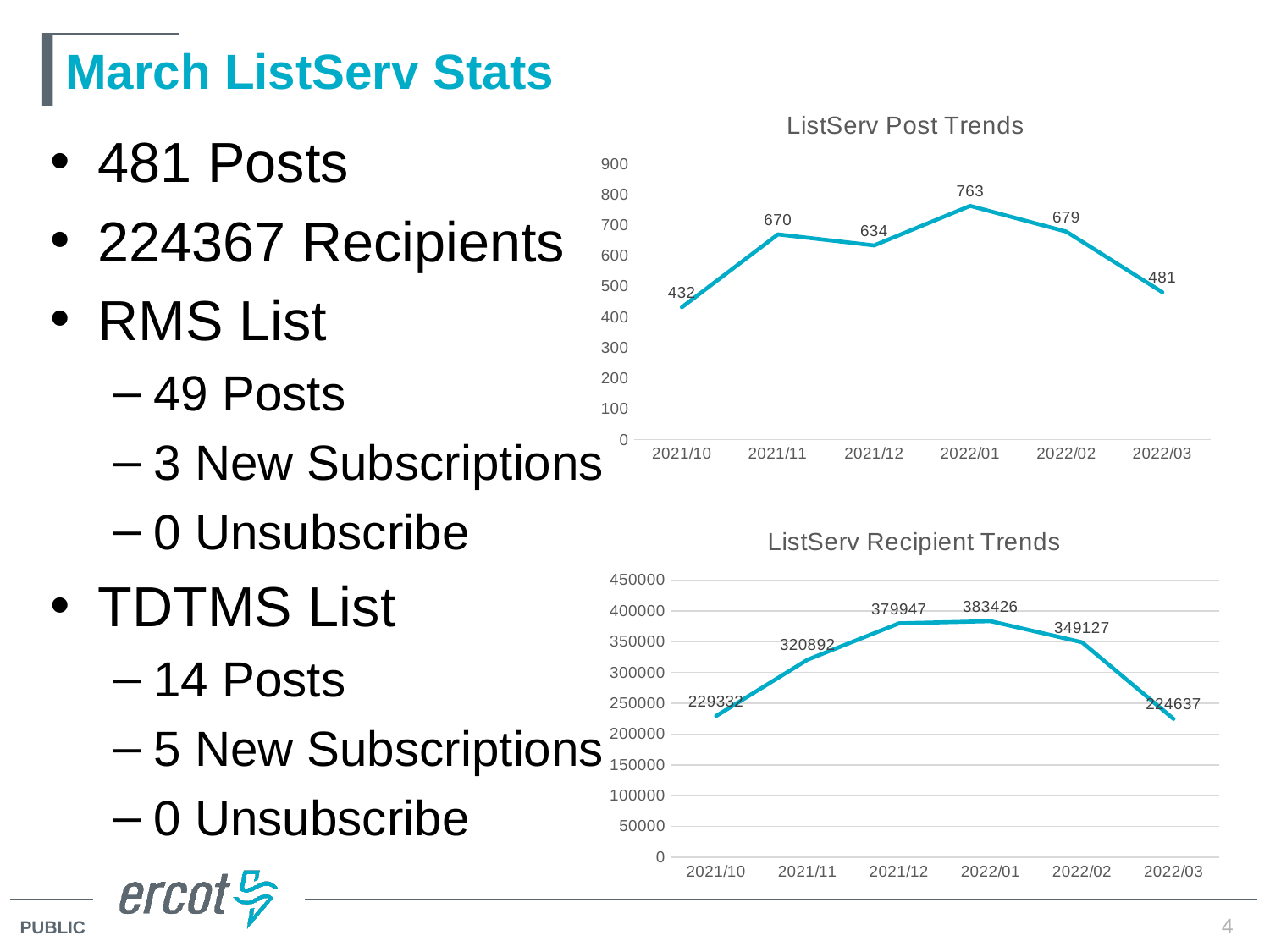
In the ListServ Recipient Trends chart, which month has the highest value? 2022/01 In the ListServ Recipient Trends chart, what is the value for 2021/11? 320892 In the ListServ Post Trends chart, how many data points are plotted? 6 In the ListServ Recipient Trends chart, what is the difference between the values for 2022/02 and 2022/03? 124490 In the ListServ Recipient Trends chart, do the values rise or fall from 2022/01 to 2022/03? fall In the ListServ Post Trends chart, which month has the lowest value? 2021/10 What is the title of the lower chart on the slide? ListServ Recipient Trends In the ListServ Recipient Trends chart, is the value for 2022/03 greater or less than 250000? less What kind of chart is the ListServ Post Trends chart? Line chart In the ListServ Post Trends chart, what is the difference between the values for 2022/01 and 2022/03? 282 In the ListServ Post Trends chart, which is larger, the value for 2021/11 or 2021/12? 2021/11 In the ListServ Post Trends chart, what is the value for 2022/01? 763